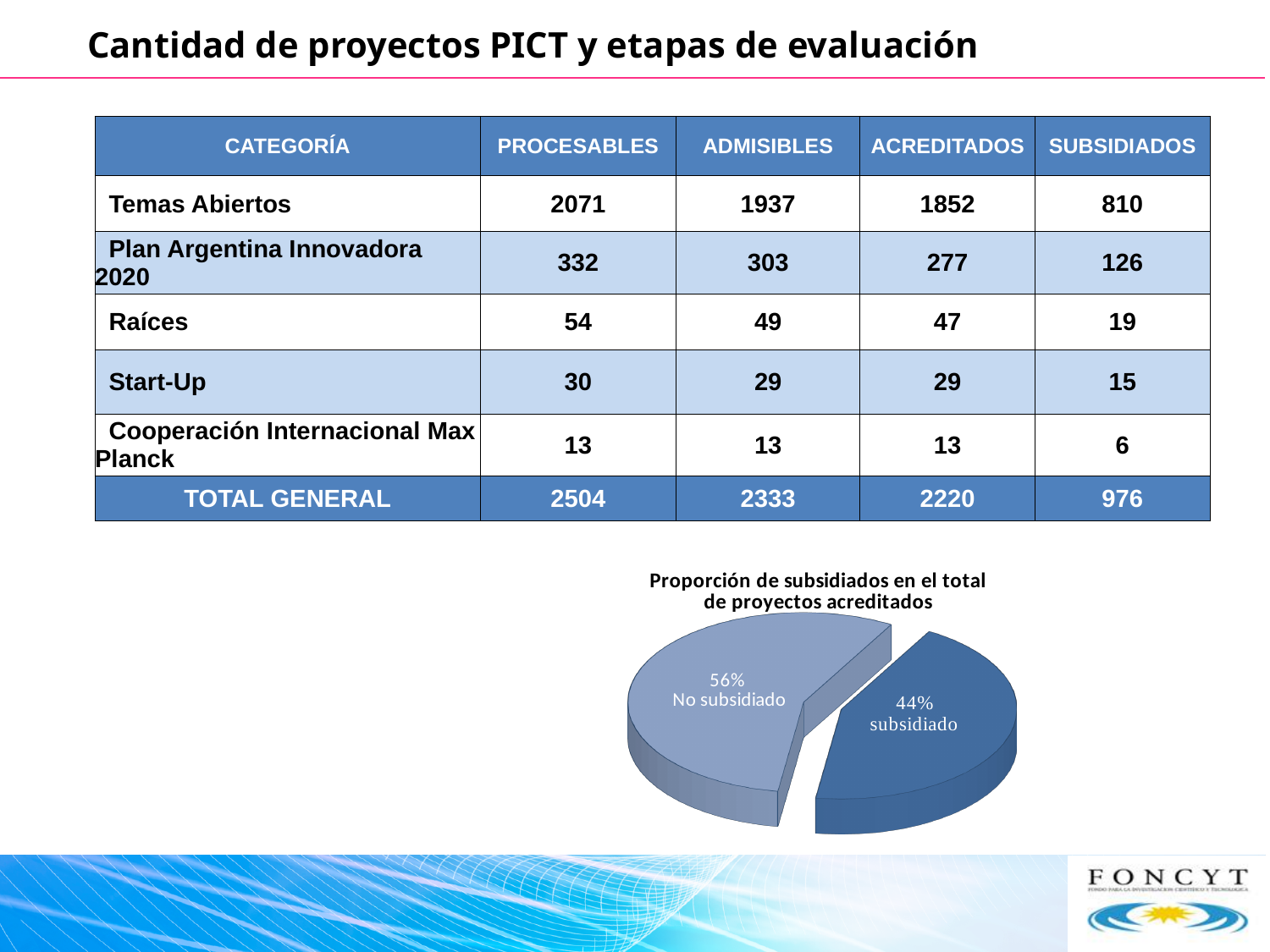
Which slice of the pie chart is larger, 'subsidiado' or 'No subsidiado'? No subsidiado What is the title of the pie chart? Proporción de subsidiados en el total de proyectos acreditados In the pie chart, what share is labelled 'No subsidiado'? 56% What kind of chart is shown on the slide? pie chart What is the difference in percentage points between the 'No subsidiado' and 'subsidiado' slices? 12 In the pie chart, what share is labelled 'subsidiado'? 44% Which slice of the pie chart is drawn in the darker blue? subsidiado Which slice of the pie chart is the smallest? subsidiado How many slices does the pie chart have? 2 Is the 'subsidiado' share in the pie chart greater or less than 50%? less